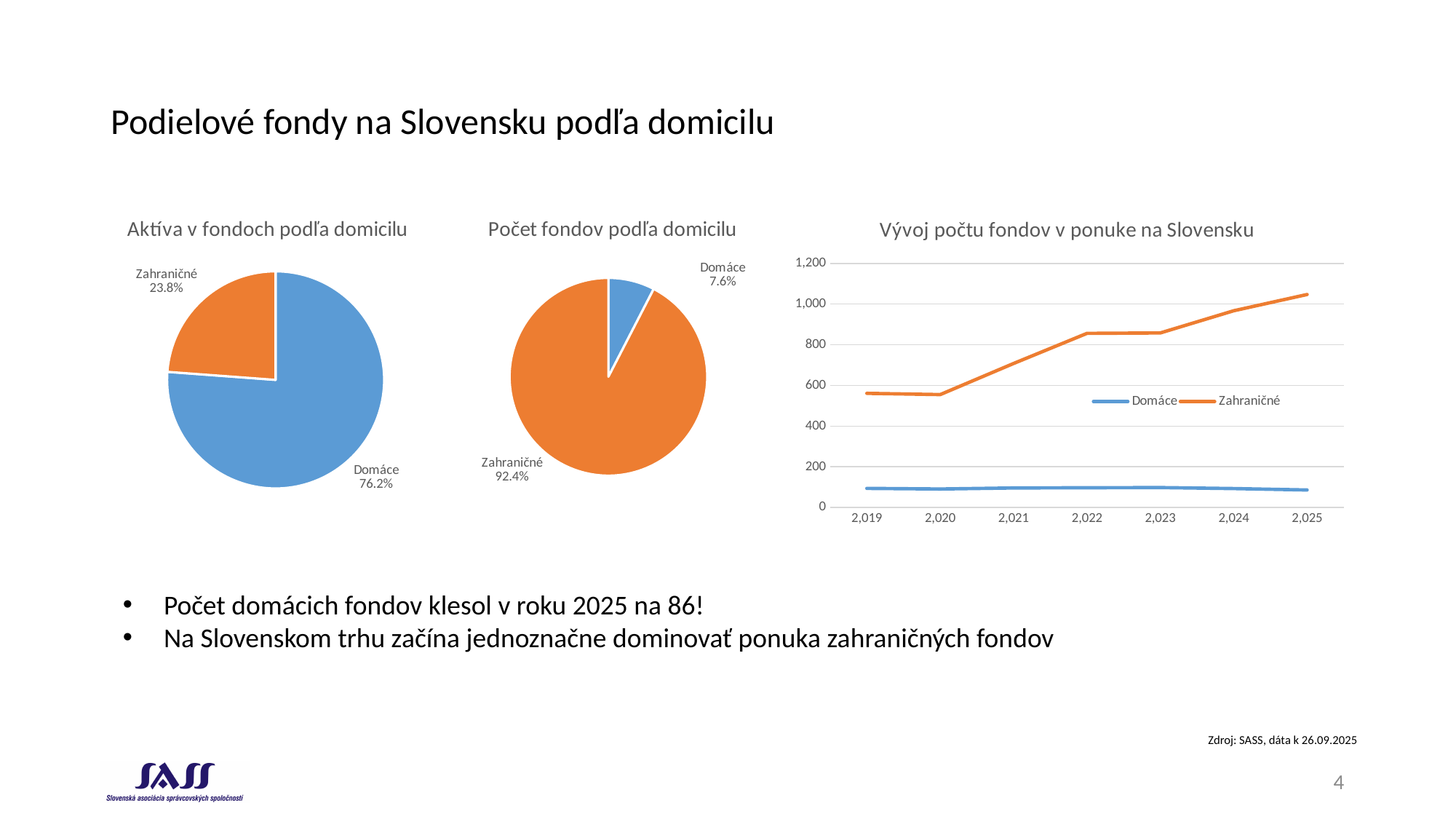
In 'Vývoj počtu fondov v ponuke na Slovensku', is the Zahraničné value for 2025 greater or less than 1,000? greater How many years are shown on the x axis of 'Vývoj počtu fondov v ponuke na Slovensku'? 7 What kind of chart is 'Aktíva v fondoch podľa domicilu'? pie chart In the chart 'Aktíva v fondoch podľa domicilu', what share do Zahraničné funds have? 23.8% In the chart 'Aktíva v fondoch podľa domicilu', what share do Domáce funds have? 76.2% In 'Vývoj počtu fondov v ponuke na Slovensku', does the Zahraničné series rise or fall from 2019 to 2025? rise In the chart 'Počet fondov podľa domicilu', what share do Domáce funds have? 7.6% How many series does the legend of 'Vývoj počtu fondov v ponuke na Slovensku' list? 2 In the chart 'Počet fondov podľa domicilu', which slice is larger, Domáce or Zahraničné? Zahraničné What kind of chart is 'Vývoj počtu fondov v ponuke na Slovensku'? line chart In the chart 'Aktíva v fondoch podľa domicilu', what is the difference between the Domáce and Zahraničné shares? 52.4%